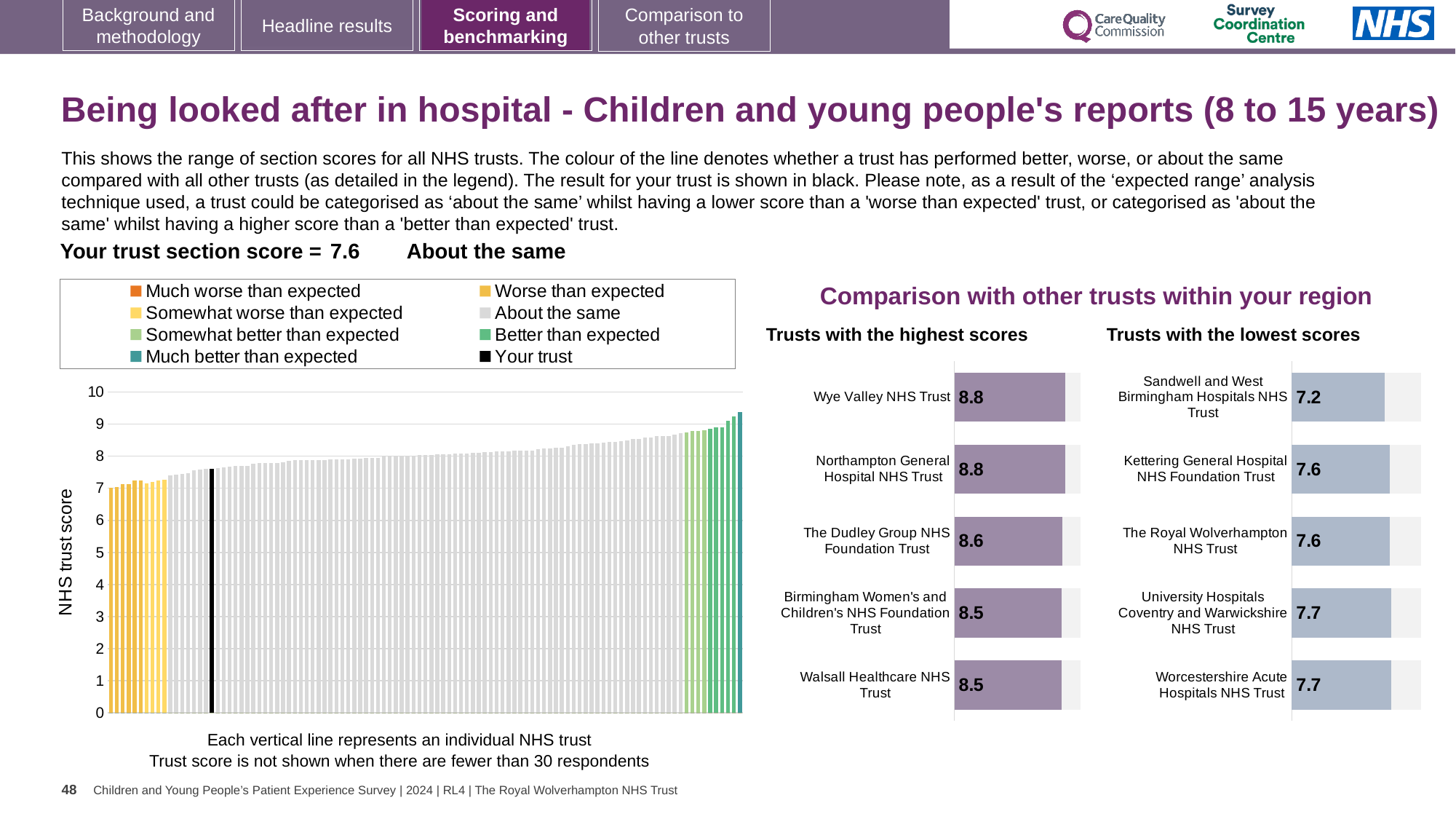
In the 'Trusts with the lowest scores' chart, what is the score for University Hospitals Coventry and Warwickshire NHS Trust? 7.7 In the large chart on the left, is the value for the black 'Your trust' line greater or less than 5? greater In the 'Trusts with the lowest scores' chart, what is the difference between the scores of Worcestershire Acute Hospitals NHS Trust and Sandwell and West Birmingham Hospitals NHS Trust? 0.5 In the 'Trusts with the highest scores' chart, what is the difference between the scores of Wye Valley NHS Trust and Walsall Healthcare NHS Trust? 0.3 What kind of chart is the large chart on the left showing NHS trust scores? Bar chart In the large chart on the left, do the trust scores rise or fall from left to right along the x axis? Rise How many trusts are shown in the 'Trusts with the lowest scores' chart? 5 In the 'Trusts with the lowest scores' chart, what is the score for Sandwell and West Birmingham Hospitals NHS Trust? 7.2 In the 'Trusts with the highest scores' chart, which has the larger score: The Dudley Group NHS Foundation Trust or Walsall Healthcare NHS Trust? The Dudley Group NHS Foundation Trust In the 'Trusts with the highest scores' chart, what is the score for The Dudley Group NHS Foundation Trust? 8.6 In the 'Trusts with the highest scores' chart, what is the score for Wye Valley NHS Trust? 8.8 In the 'Trusts with the lowest scores' chart, which trust has the lowest score? Sandwell and West Birmingham Hospitals NHS Trust